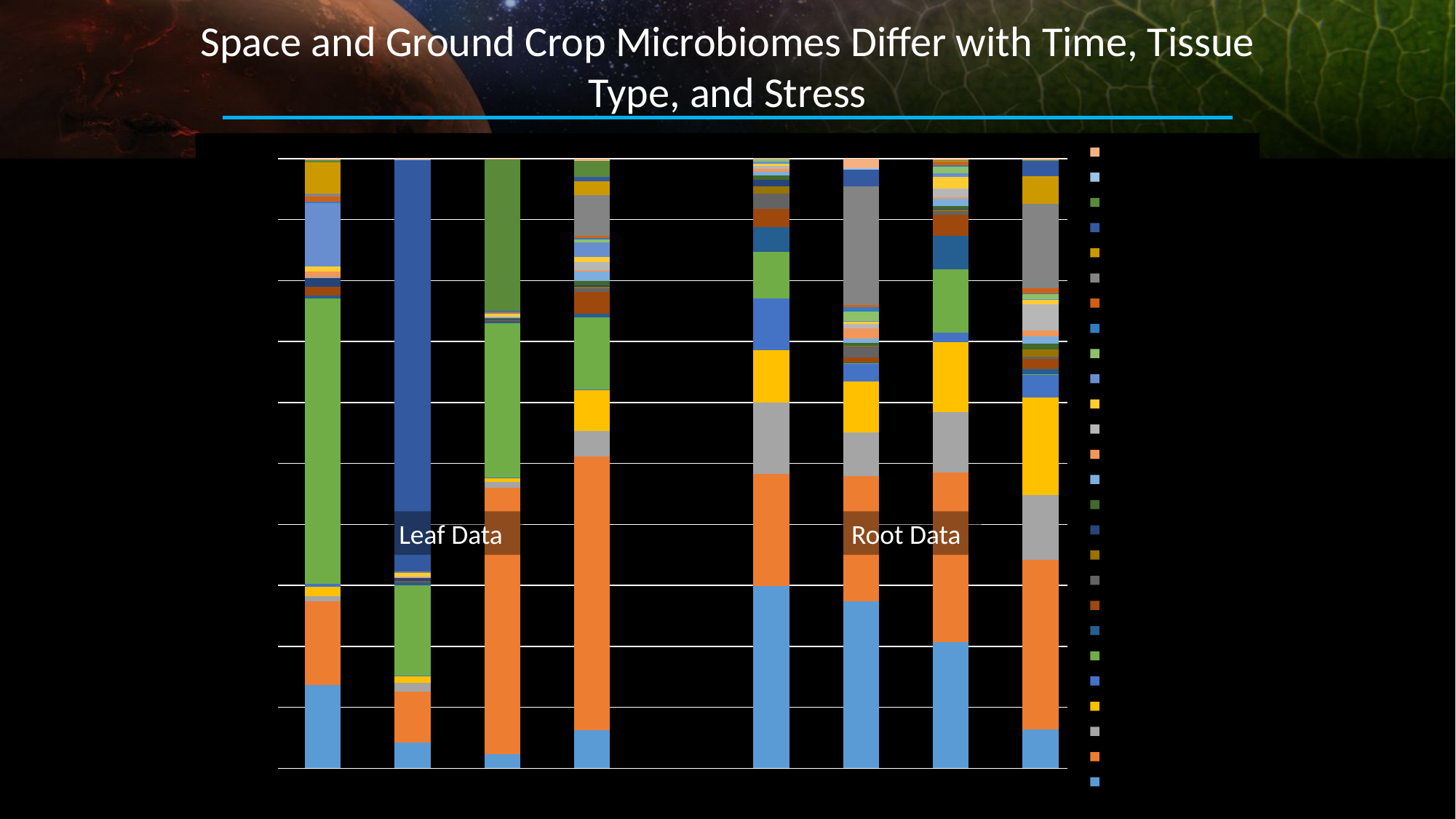
What kind of chart is shown on the slide? Stacked bar chart What colour is the segment at the bottom of every bar in the chart? Blue Which group of bars, Leaf Data or Root Data, has the larger blue bottom segments overall? Root Data What are the two group labels written over the chart? Leaf Data and Root Data How many bars are in the group labelled "Leaf Data"? 4 How many bars are plotted in the chart? 8 How many bars are in the group labelled "Root Data"? 4